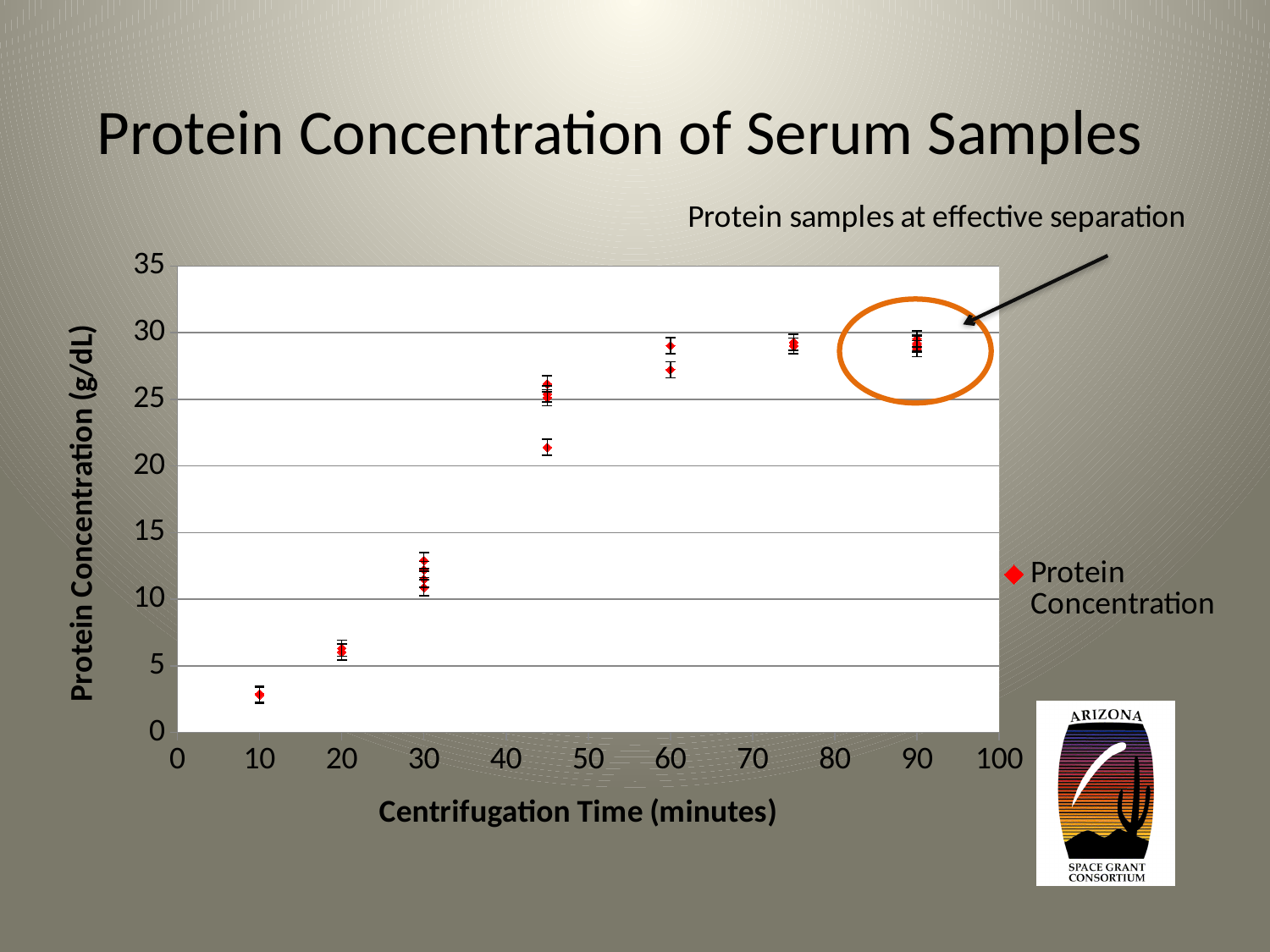
Are the protein concentration values at 90 minutes greater or less than 25 g/dL? greater Which has the higher protein concentration, the samples at 20 minutes or the samples at 60 minutes? 60 minutes How many distinct centrifugation times have data points plotted? 7 What is the title of the chart? Protein Concentration of Serum Samples What is the label of the x axis? Centrifugation Time (minutes) At which centrifugation time is the protein concentration lowest? 10 minutes Are the protein concentration values at 45 minutes greater or less than 20 g/dL? greater Is the protein concentration at 10 minutes greater or less than 5 g/dL? less What kind of chart is shown on the slide? Scatter chart How many series does the legend list? 1 Do the protein concentration values rise or fall as centrifugation time increases? Rise